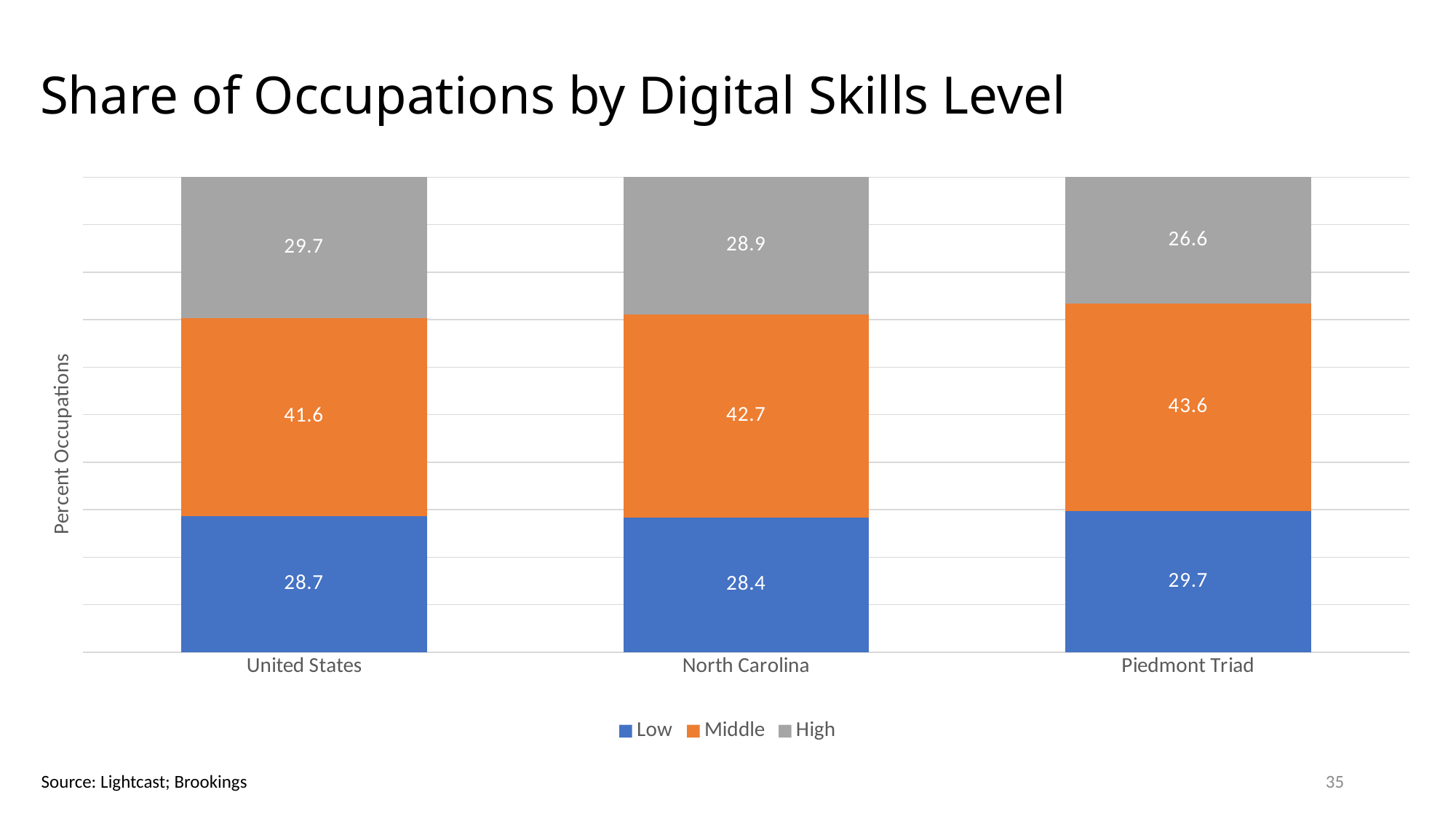
What is the total of the stacked bar for North Carolina? 100.0 What is the High value for North Carolina? 28.9 How many series does the legend list? 3 Which is larger, the High value for the United States or the High value for Piedmont Triad? United States What is the difference between the Middle values for Piedmont Triad and the United States? 2.0 What is the Low value for the United States? 28.7 What kind of chart is shown on the slide? Stacked bar chart What is the Middle value for Piedmont Triad? 43.6 Which category has the highest High value? United States Which category has the lowest Middle value? United States How many categories are shown on the x axis? 3 What is the title of the chart? Share of Occupations by Digital Skills Level